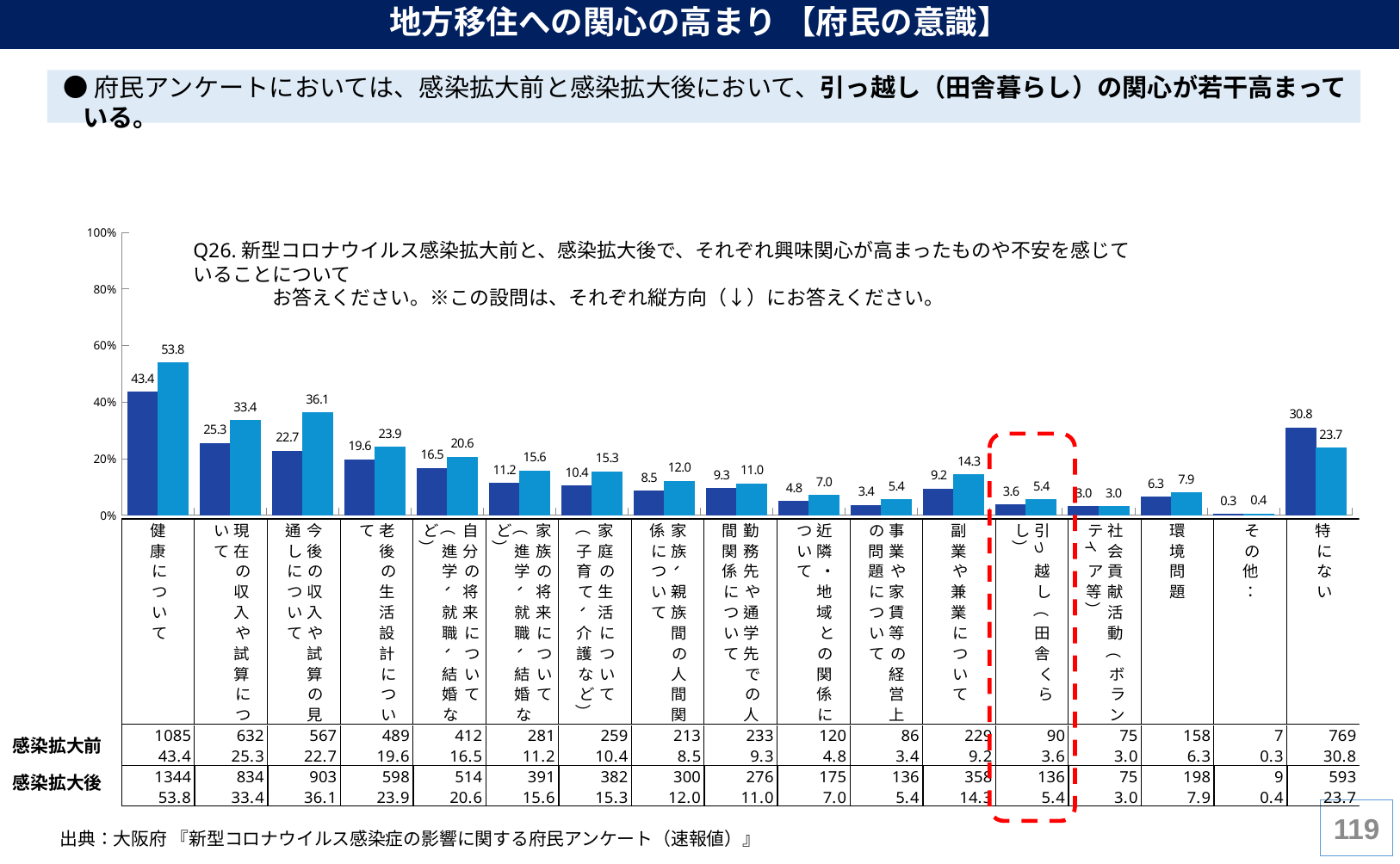
Which category is highlighted with a red dashed box on the chart? 引っ越し（田舎くらし） What is the difference between the 感染拡大後 and 感染拡大前 values for 今後の収入や試算の見通しについて? 13.4 What is the value for 特にない in the 感染拡大後 series? 23.7 What is the value for 引っ越し（田舎くらし） in the 感染拡大前 series? 3.6 What type of chart is shown on the slide? bar chart What is the value for 健康について in the 感染拡大後 series? 53.8 How many data series does the chart show? 2 Which category has the lowest value in the 感染拡大後 series? その他： Is the 感染拡大後 value for 健康について greater or less than 40%? greater Which category has the highest value in the 感染拡大前 series? 健康について Which is larger for 特にない: the 感染拡大前 value or the 感染拡大後 value? 感染拡大前 How many categories are shown on the x axis of the chart? 17